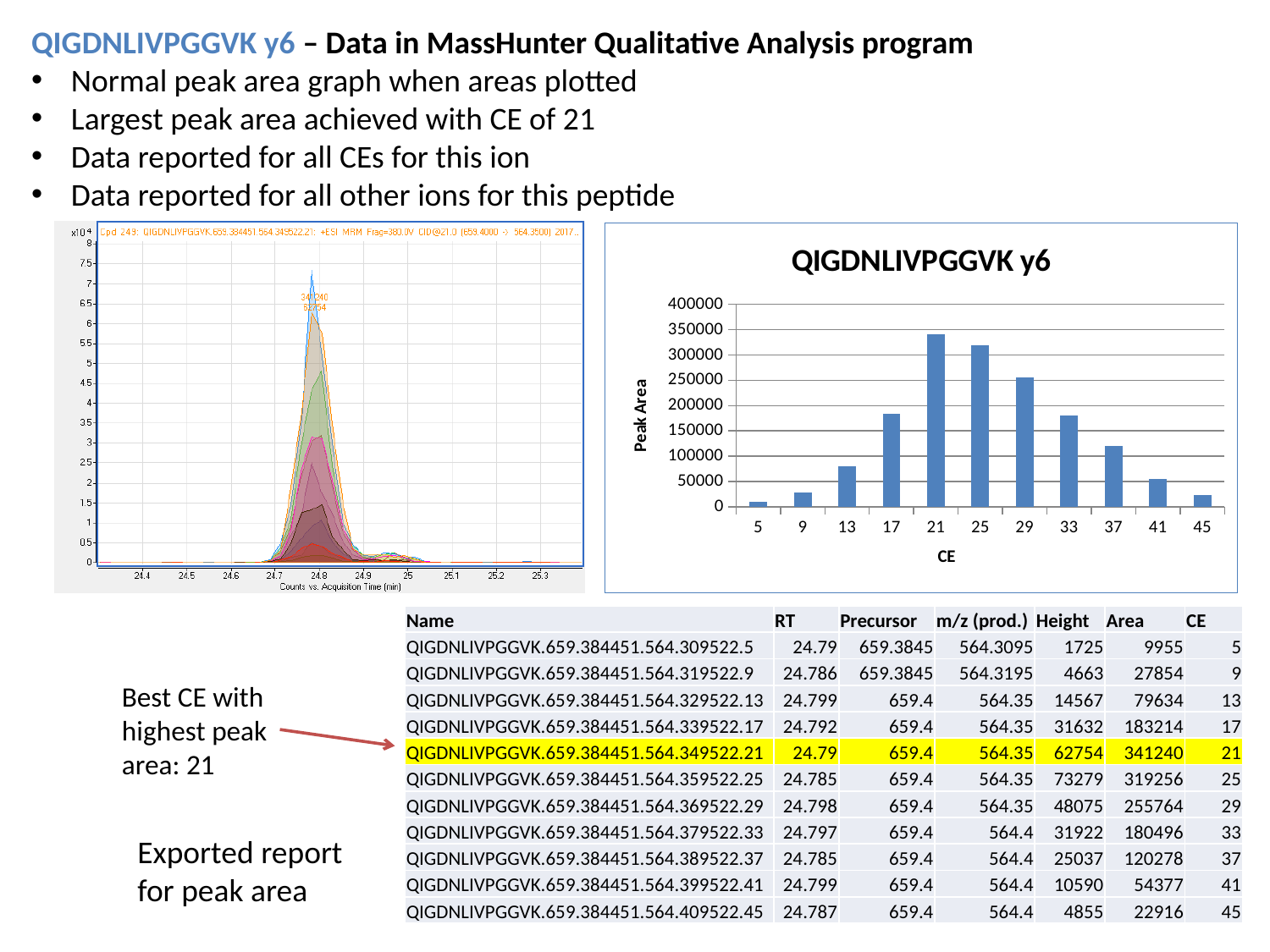
In the QIGDNLIVPGGVK y6 bar chart, which has the larger peak area, CE 25 or CE 29? CE 25 In the QIGDNLIVPGGVK y6 bar chart, how many CE values are plotted on the x axis? 11 In the QIGDNLIVPGGVK y6 bar chart, is the peak area for CE 45 greater or less than 50000? less In the QIGDNLIVPGGVK y6 bar chart, which has the larger peak area, CE 13 or CE 41? CE 13 In the QIGDNLIVPGGVK y6 bar chart, how does peak area change as CE increases from 5 to 45? rises to a peak at 21, then falls In the QIGDNLIVPGGVK y6 bar chart, is the peak area for CE 29 greater or less than 200000? greater In the QIGDNLIVPGGVK y6 bar chart, is the peak area for CE 21 greater or less than 300000? greater In the QIGDNLIVPGGVK y6 bar chart, what kind of chart is shown? bar chart In the QIGDNLIVPGGVK y6 bar chart, which CE value has the lowest peak area? 5 In the QIGDNLIVPGGVK y6 bar chart, which CE value has the highest peak area? 21 In the QIGDNLIVPGGVK y6 bar chart, what is the label on the y axis? Peak Area